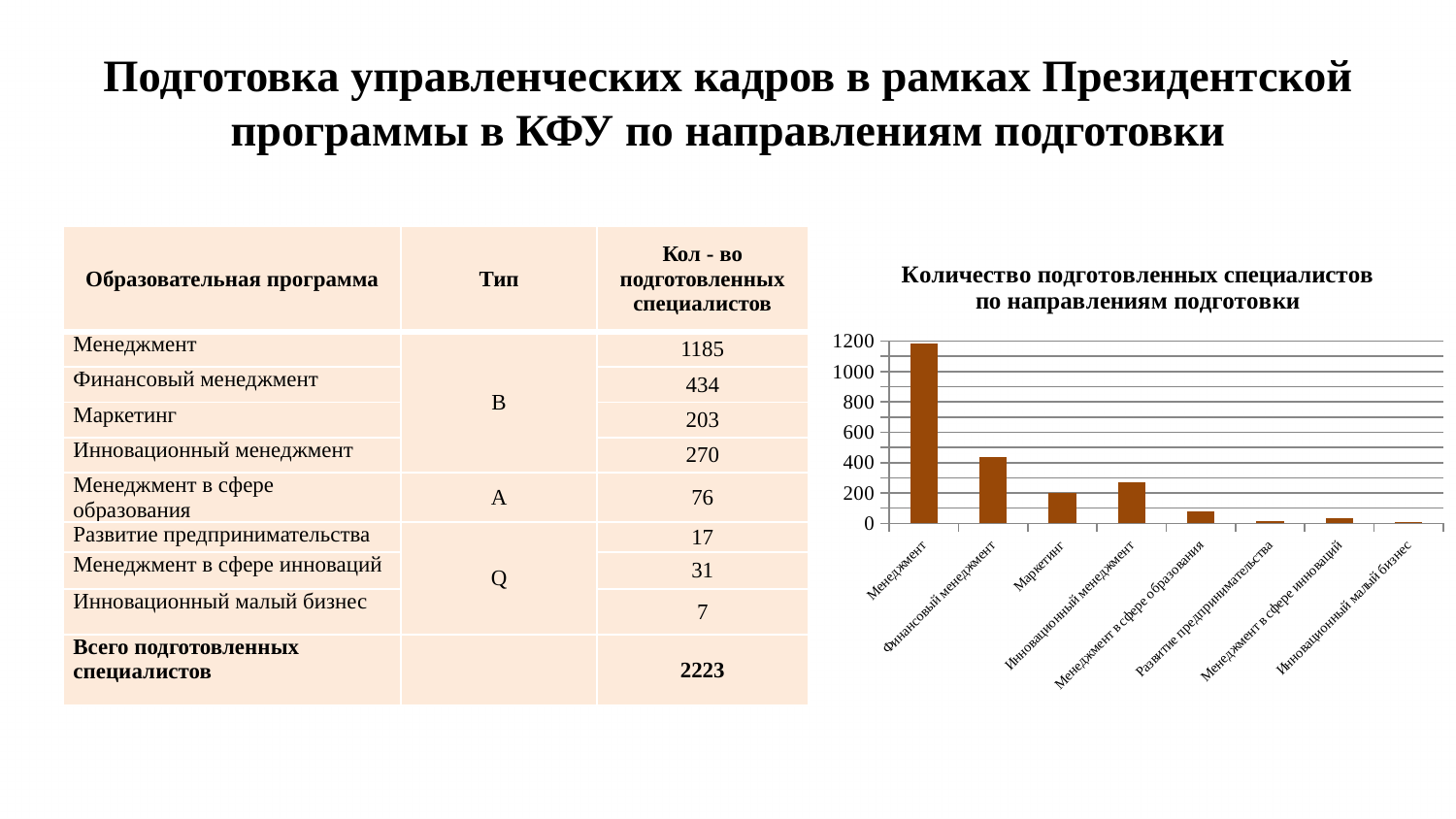
Is the value for Финансовый менеджмент greater or less than 400? greater Which is larger on the chart, Инновационный менеджмент or Маркетинг? Инновационный менеджмент Is the value for Маркетинг greater or less than 400? less What is the title of the chart? Количество подготовленных специалистов по направлениям подготовки Is the value for Менеджмент в сфере образования greater or less than 200? less What kind of chart is shown on the slide? bar chart Which is larger on the chart, Финансовый менеджмент or Инновационный менеджмент? Финансовый менеджмент Which category has the highest bar on the chart? Менеджмент How many categories are plotted on the chart? 8 According to the slide, how many specialists were trained in Менеджмент? 1185 According to the slide, what is the difference between the number of specialists trained in Финансовый менеджмент and in Маркетинг? 231